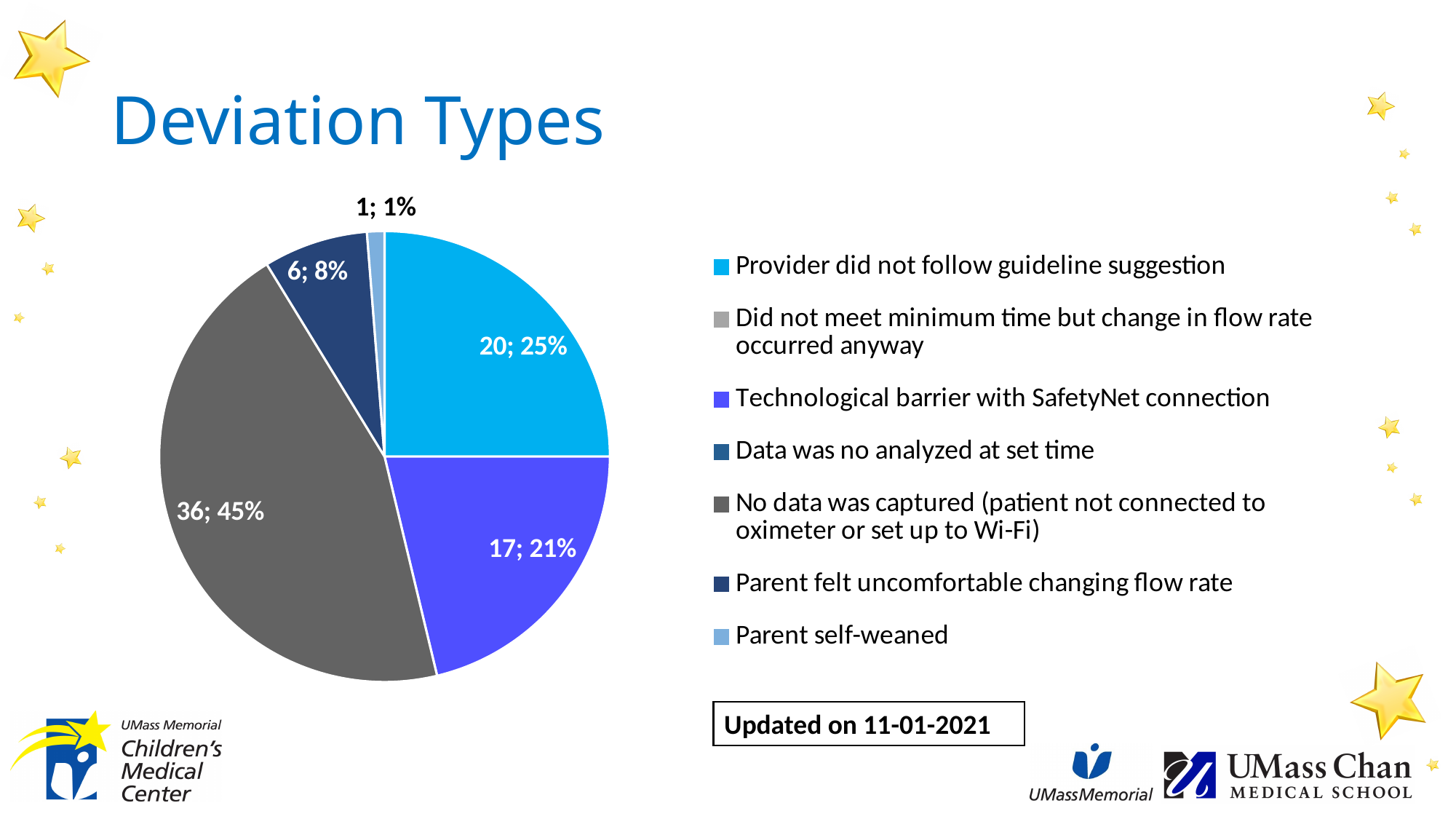
How many deviations are labeled for 'Provider did not follow guideline suggestion'? 20 What is the title of the chart on the slide? Deviation Types What kind of chart is shown on the slide? pie chart How many deviations are labeled for 'No data was captured (patient not connected to oximeter or set up to Wi-Fi)'? 36 Which deviation type has the largest slice of the pie? No data was captured (patient not connected to oximeter or set up to Wi-Fi) Which is larger: the slice for 'Provider did not follow guideline suggestion' or the slice for 'Technological barrier with SafetyNet connection'? Provider did not follow guideline suggestion How many deviations are labeled for 'Parent felt uncomfortable changing flow rate'? 6 What share of the pie does 'Technological barrier with SafetyNet connection' represent? 21% What share of the pie does 'Provider did not follow guideline suggestion' represent? 25% How many entries does the chart's legend list? 7 What is the difference between the count for 'No data was captured' and the count for 'Provider did not follow guideline suggestion'? 16 What share of the pie does 'No data was captured (patient not connected to oximeter or set up to Wi-Fi)' represent? 45%